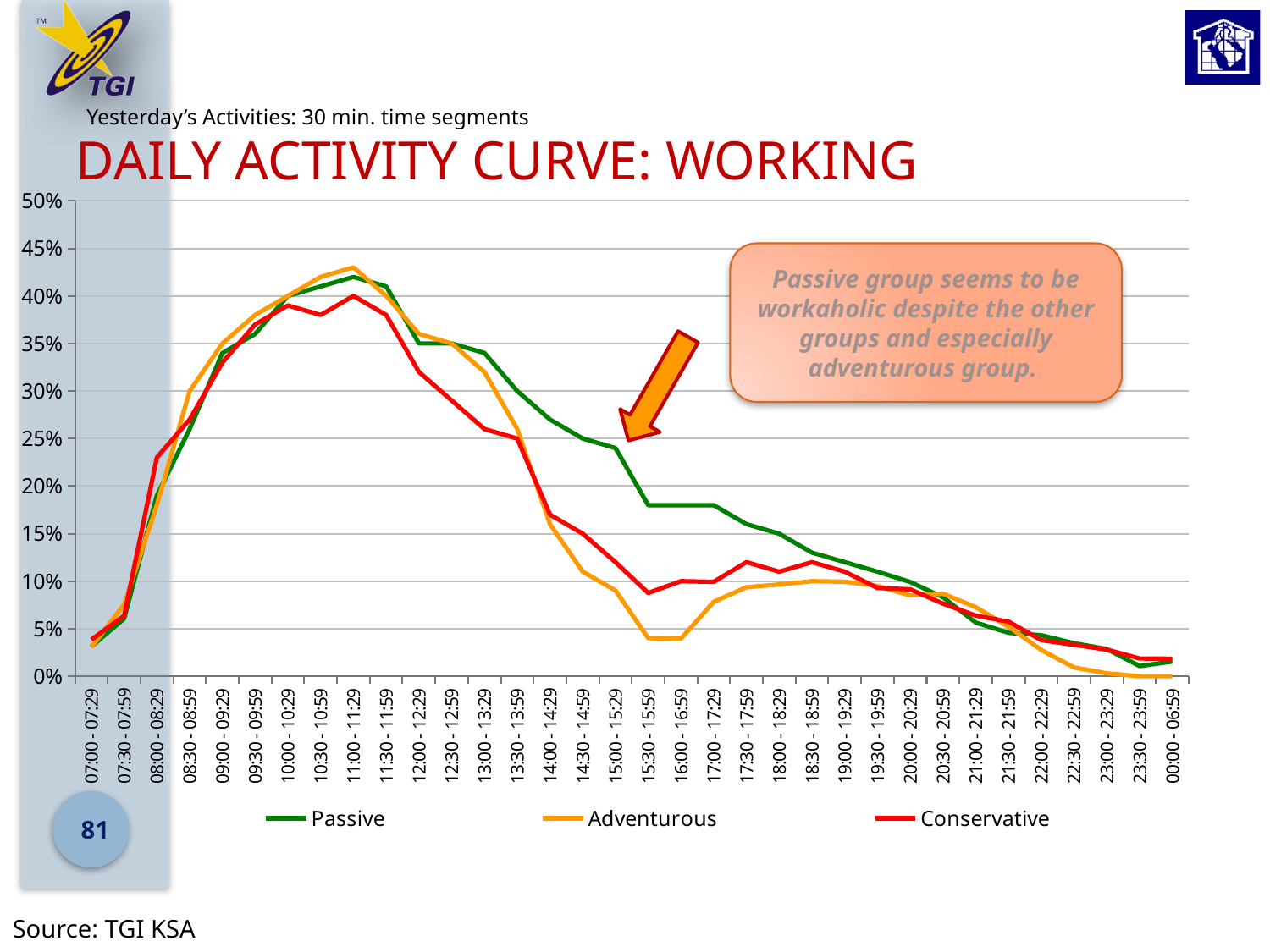
What colour is the Passive line in the legend? green Does the Passive line rise or fall from 11:00 - 11:29 to 15:30 - 15:59? fall At 08:00 - 08:29, which series has the higher value, Conservative or Passive? Conservative What kind of chart is shown on the slide? line chart Which series reaches the highest peak value on the chart? Adventurous Is the value for Adventurous at 15:30 - 15:59 greater or less than 10%? less Is the value for Adventurous at 11:00 - 11:29 greater or less than 40%? greater Is the value for Conservative at 14:00 - 14:29 greater or less than 20%? less How many time segments are plotted along the x axis? 34 How many series does the legend list? 3 At 15:30 - 15:59, which series has the higher value, Passive or Adventurous? Passive